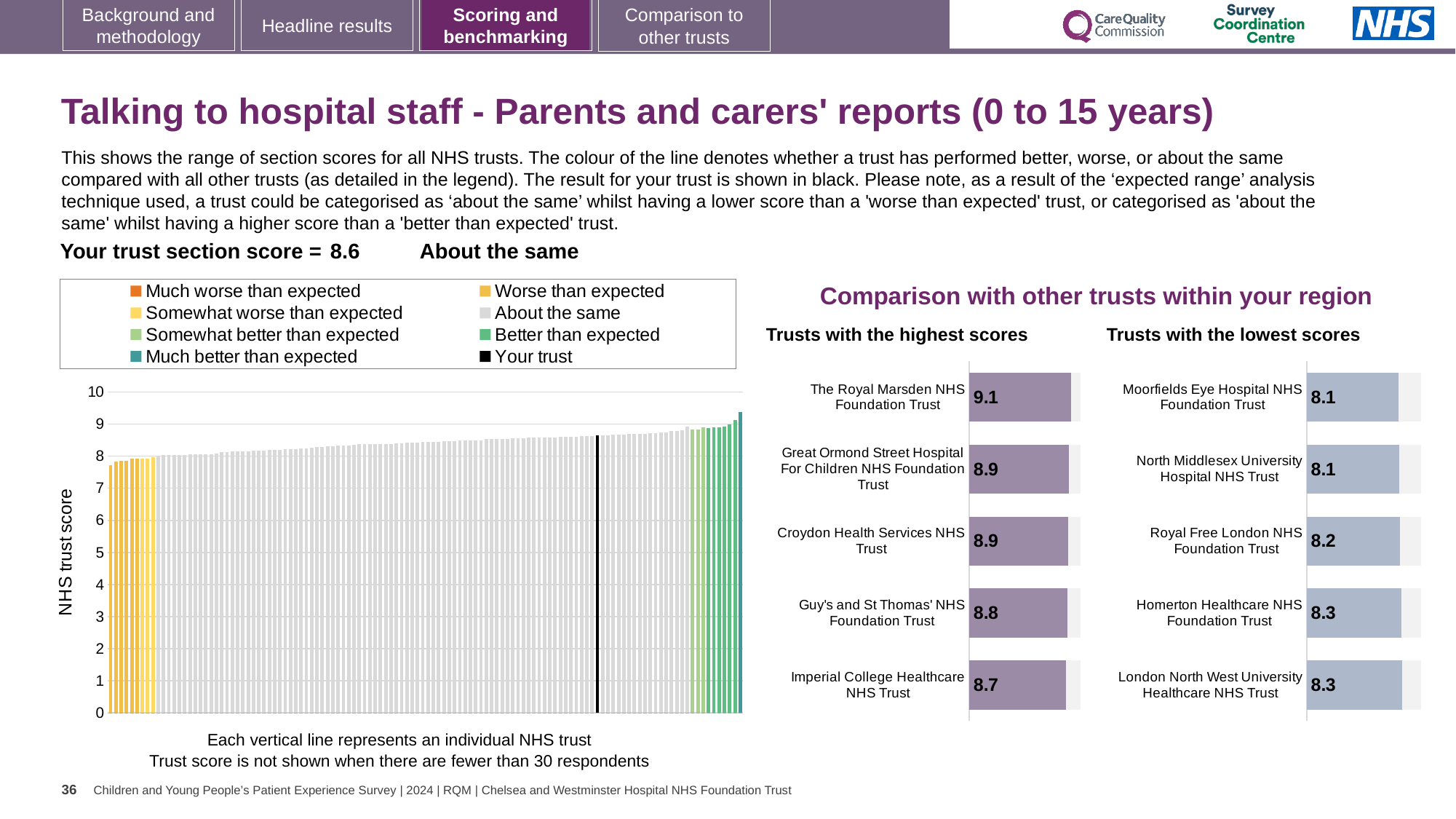
In the large chart on the left showing all NHS trusts, what kind of chart is it? Bar chart In the large chart on the left showing all NHS trusts, how many entries does the legend list? 8 In the 'Trusts with the lowest scores' chart, what is the score for Homerton Healthcare NHS Foundation Trust? 8.3 In the 'Trusts with the lowest scores' chart, what is the difference between the scores of Royal Free London NHS Foundation Trust and Moorfields Eye Hospital NHS Foundation Trust? 0.1 In the 'Trusts with the highest scores' chart, what is the score for Imperial College Healthcare NHS Trust? 8.7 In the 'Trusts with the highest scores' chart, how many trusts are shown? 5 In the 'Trusts with the lowest scores' chart, which is larger: the score for Homerton Healthcare NHS Foundation Trust or Moorfields Eye Hospital NHS Foundation Trust? Homerton Healthcare NHS Foundation Trust In the 'Trusts with the lowest scores' chart, what is the score for Royal Free London NHS Foundation Trust? 8.2 In the 'Trusts with the highest scores' chart, what is the difference between the scores of The Royal Marsden NHS Foundation Trust and Imperial College Healthcare NHS Trust? 0.4 In the large chart on the left showing all NHS trusts, is the value for the black 'Your trust' bar greater or less than 8? greater In the 'Trusts with the highest scores' chart, which trust has the highest score? The Royal Marsden NHS Foundation Trust In the 'Trusts with the highest scores' chart, what is the score for The Royal Marsden NHS Foundation Trust? 9.1